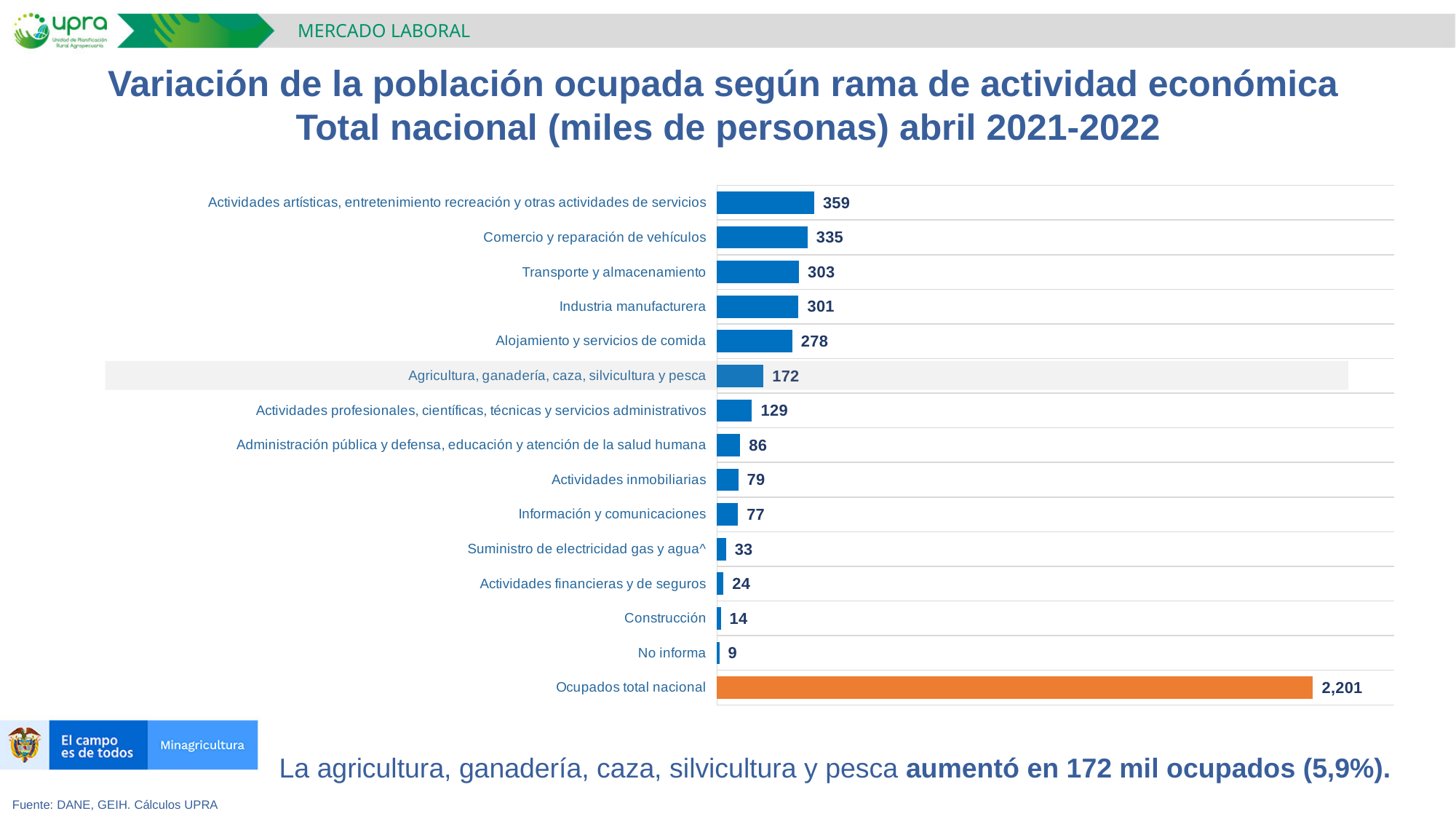
What kind of chart is shown on the slide? Bar chart What is the value for Construcción? 14 What is the value for Ocupados total nacional? 2,201 How many categories are shown in the chart? 15 Which category has the lowest value? No informa What is the value for Agricultura, ganadería, caza, silvicultura y pesca? 172 What is the difference between the values for Industria manufacturera and Agricultura, ganadería, caza, silvicultura y pesca? 129 What is the value for Transporte y almacenamiento? 303 Which category has the highest value? Ocupados total nacional Which is larger, the value for Alojamiento y servicios de comida or the value for Actividades profesionales, científicas, técnicas y servicios administrativos? Alojamiento y servicios de comida Which bar is shown in orange rather than blue? Ocupados total nacional What is the difference between the values for Actividades artísticas, entretenimiento recreación y otras actividades de servicios and Comercio y reparación de vehículos? 24